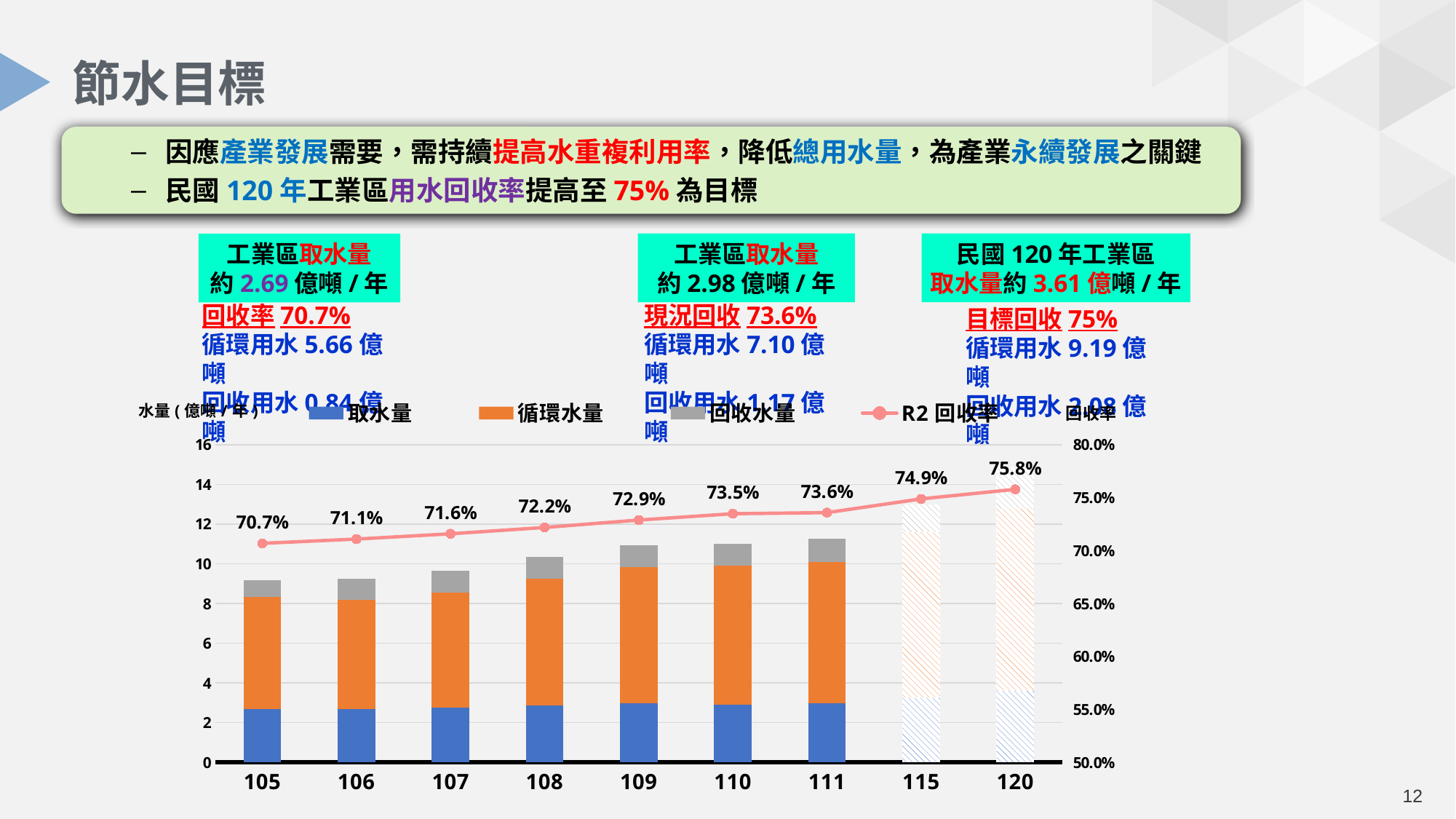
Is the total height of the stacked bar for year 111 greater or less than 10? greater Does the R2 回收率 rise or fall from year 105 to year 120? rises What is the R2 回收率 value shown for year 105? 70.7% By how many percentage points does the R2 回收率 for year 120 exceed that for year 105? 5.1 Which year has the highest R2 回收率 on the chart? 120 What is the R2 回收率 value shown for year 109? 72.9% Which year has a higher R2 回收率, 108 or 110? 110 Is the 取水量 segment for year 105 greater or less than 4? less How many years are shown on the x axis of the chart? 9 What is the R2 回收率 value shown for year 120? 75.8% Which year has the lowest R2 回收率 on the chart? 105 How many series does the chart legend list? 4